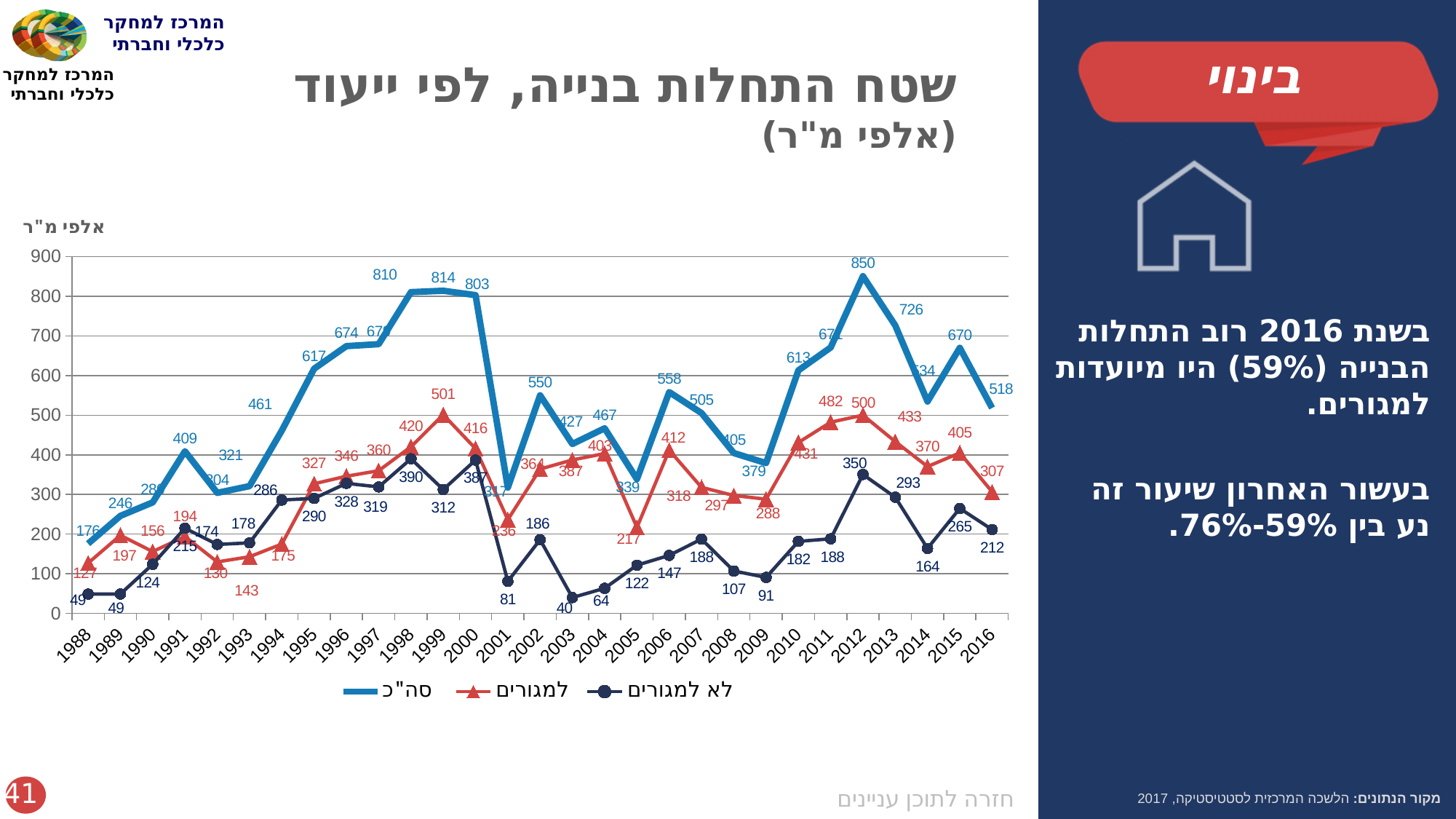
How many years are shown on the x axis? 29 Does the סה"כ series rise or fall from 2012 to 2014? fall Is the value of the סה"כ series in 2011 greater or less than 600? greater In which year does the סה"כ series reach its highest value? 2012 What is the value of the למגורים series in 1999? 501 What is the value of the סה"כ series in 2012? 850 What is the difference between the למגורים values in 2012 and 2016? 193 What is the value of the לא למגורים series in 2003? 40 What kind of chart is shown on the slide? line chart In which year does the לא למגורים series reach its lowest value? 2003 Which is larger in 2016, the למגורים value or the לא למגורים value? למגורים How many series does the legend list? 3